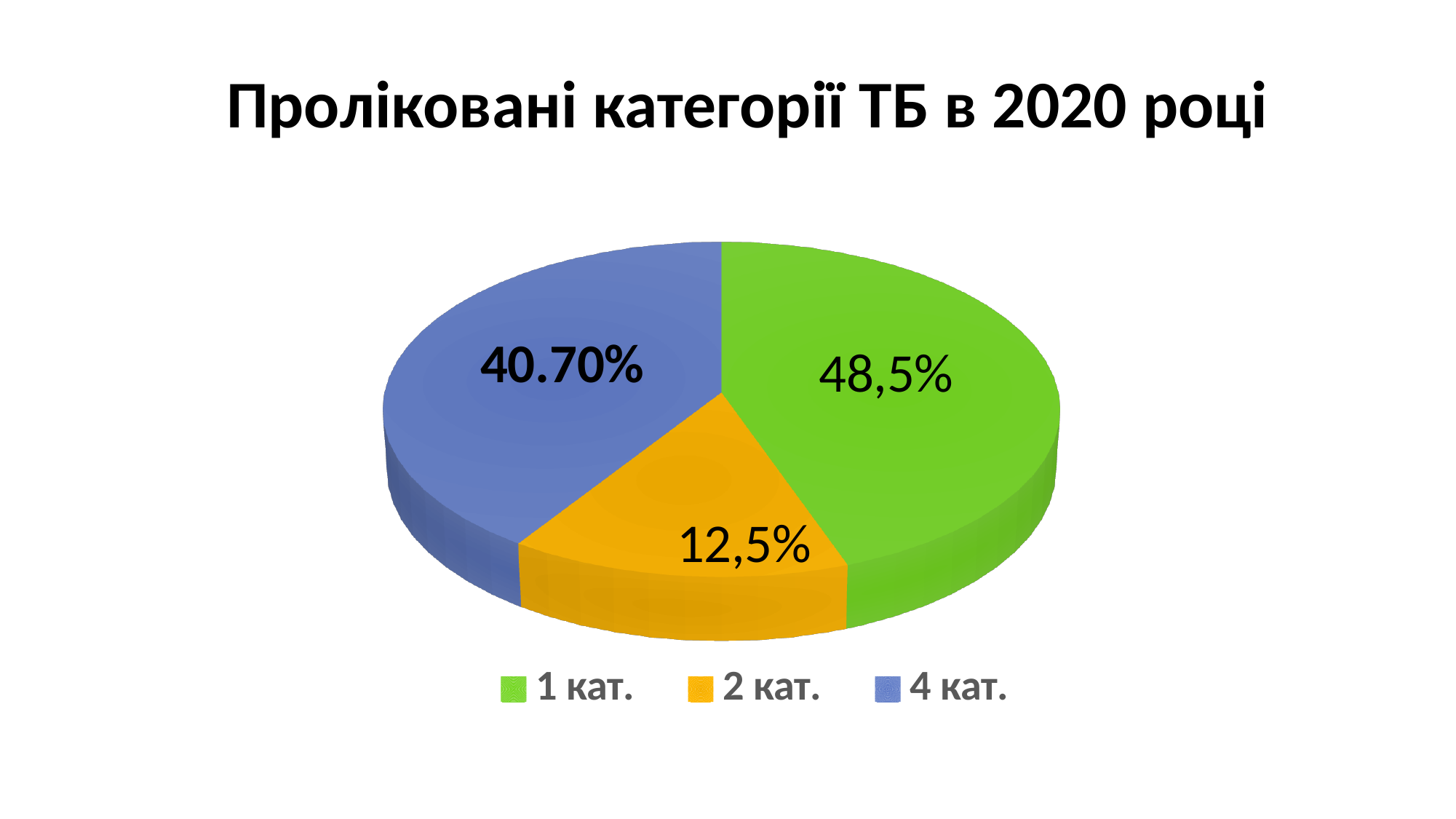
How many entries does the legend list? 3 What share of the pie does 2 кат. have? 12,5% Which is larger, the share for 1 кат. or the share for 4 кат.? 1 кат. What is the difference between the share for 1 кат. and the share for 2 кат.? 36 percentage points Which category has the largest slice of the pie? 1 кат. What is the title of the chart? Проліковані категорії ТБ в 2020 році What type of chart is shown on the slide? pie chart Which colour represents 2 кат. in the chart? orange How many slices does the pie chart have? 3 What share of the pie does 4 кат. have? 40.70% What share of the pie does 1 кат. have? 48,5% Which category has the smallest slice of the pie? 2 кат.